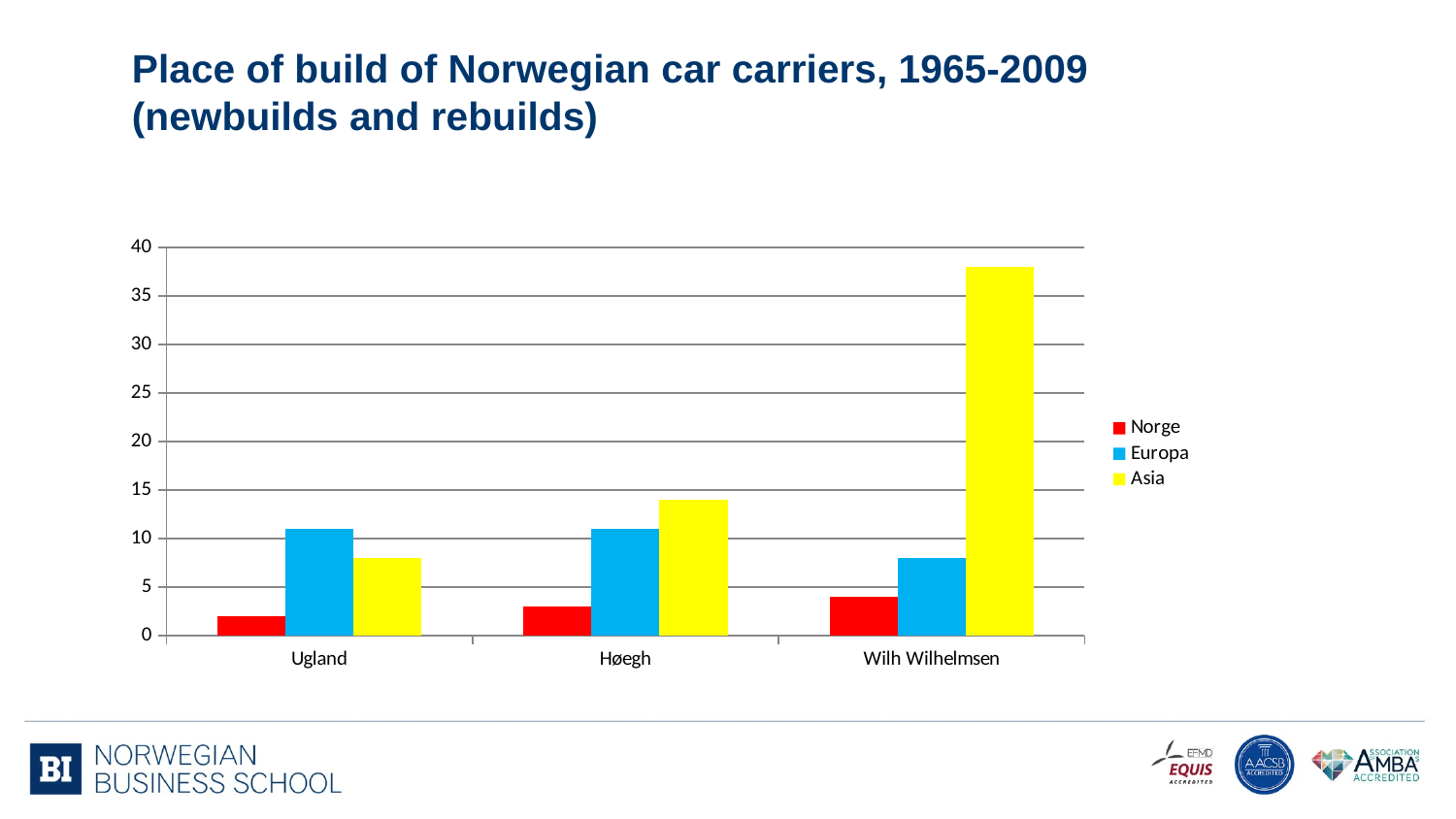
How many companies are shown on the x axis? 3 Is the Asia value for Wilh Wilhelmsen greater or less than 35? greater Is the Europa value for Ugland greater or less than 10? greater Is the Asia value for Høegh greater or less than 15? less For Ugland, which is larger: the Europa bar or the Asia bar? Europa Which company has the lowest Norge bar? Ugland How many series does the legend list? 3 Which company has the highest Asia bar? Wilh Wilhelmsen What kind of chart is shown on the slide? bar chart For Høegh, which is larger: the Asia bar or the Norge bar? Asia Which colour represents the Asia series in the legend? yellow